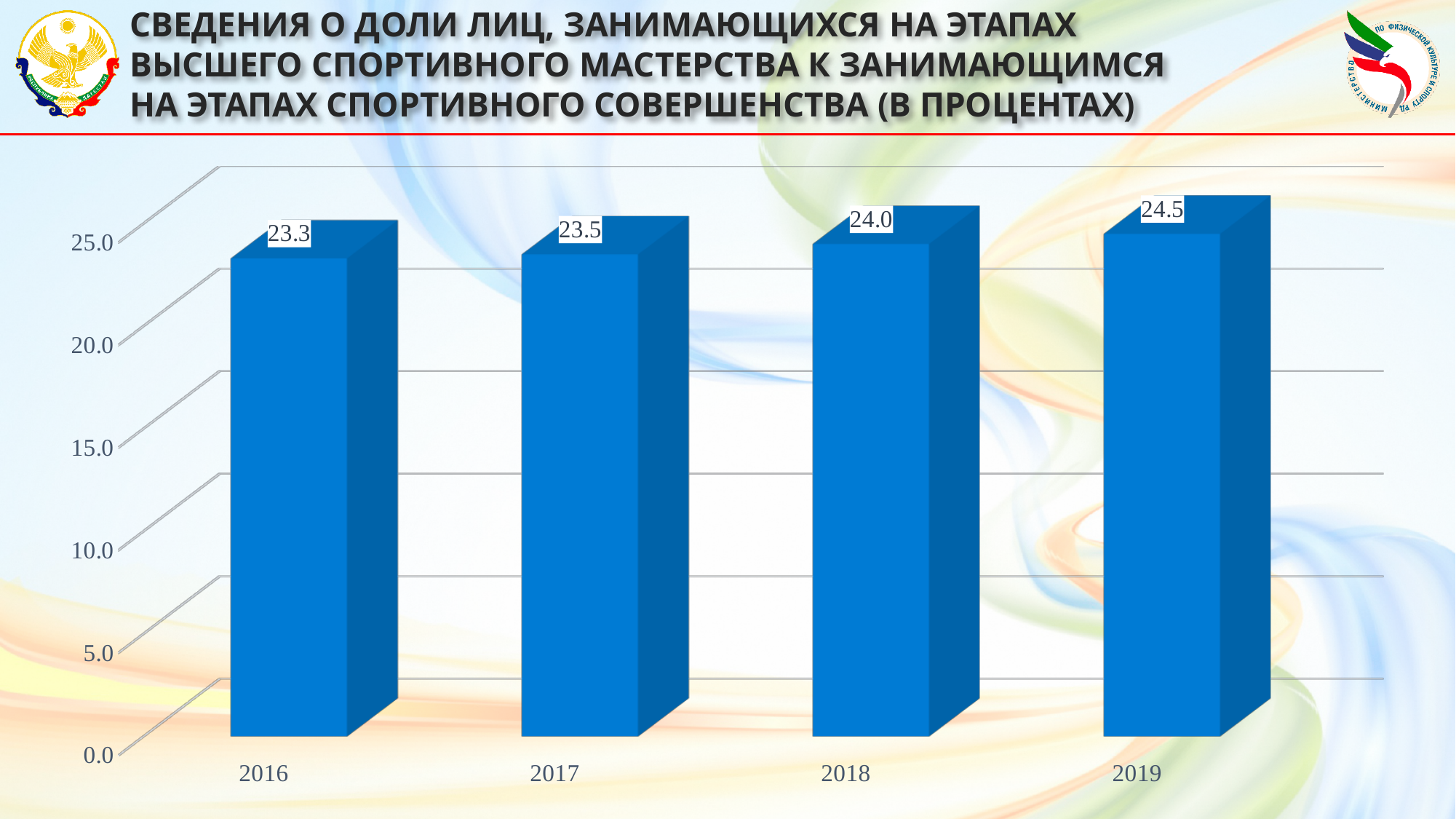
What is the difference between the values for 2018 and 2017? 0.5 What is the value for 2017? 23.5 Which year has the highest value? 2019 Which is larger, the value for 2018 or the value for 2016? 2018 Do the values rise or fall from 2016 to 2019? rise What kind of chart is shown on the slide? bar chart What is the value for 2018? 24.0 What is the value for 2019? 24.5 What is the difference between the values for 2019 and 2016? 1.2 What is the value for 2016? 23.3 Which year has the lowest value? 2016 How many years are shown on the x axis? 4